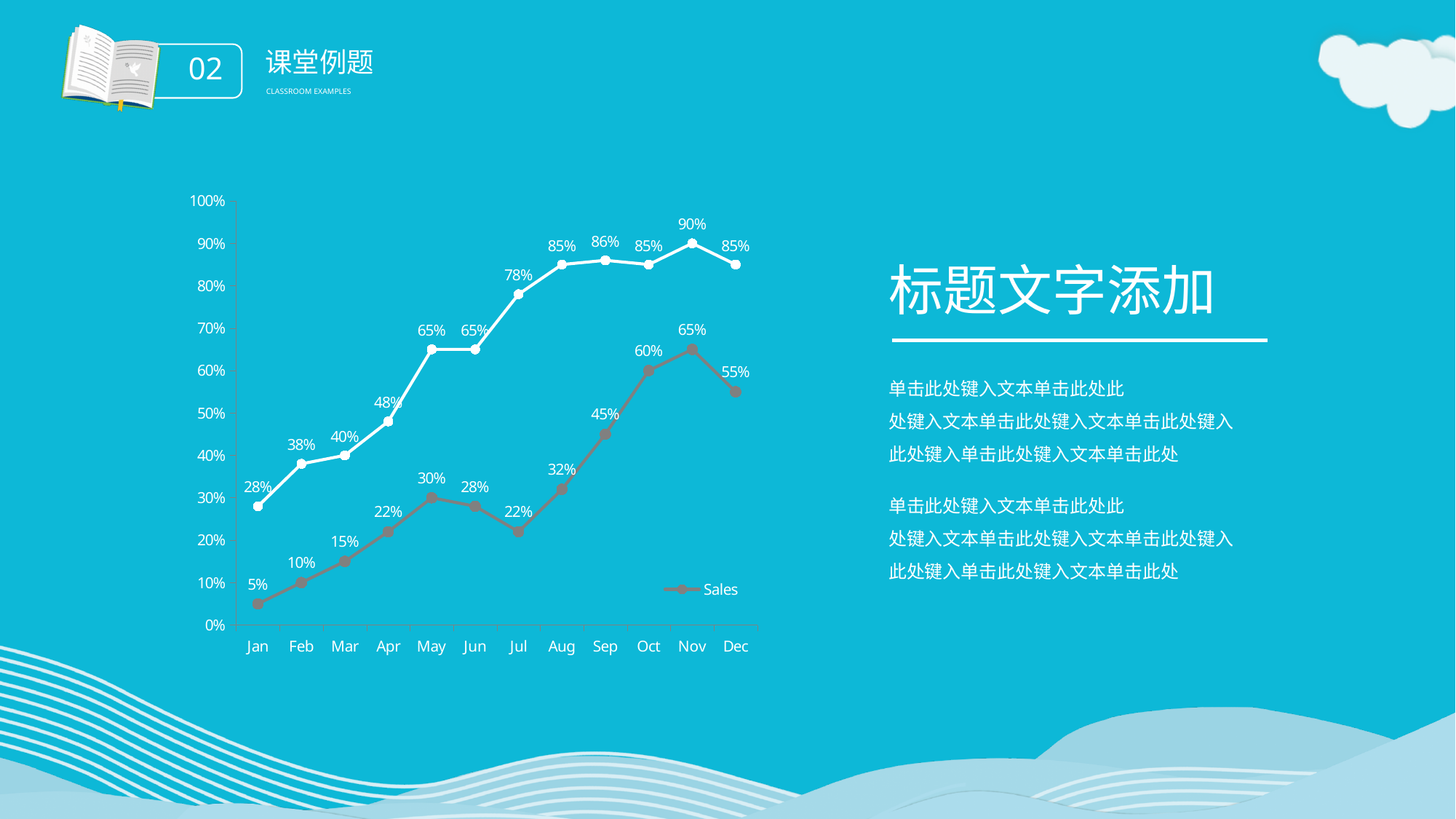
What is the difference between the Sales values for Nov and Dec? 10% Which month has the larger Sales value, Aug or Sep? Sep What kind of chart is shown on the slide? line chart Does the Sales series rise or fall from Jan to May? rise In which month is the Sales series highest? Nov How many months are shown on the x axis? 12 How many series does the legend list? 1 What is the Sales value for Oct? 60% In which month is the Sales series lowest? Jan What is the value of the white (upper) line for Jul? 78% By how much does the white (upper) line increase from Jun to Jul? 13% In which month does the white (upper) line reach its highest value? Nov